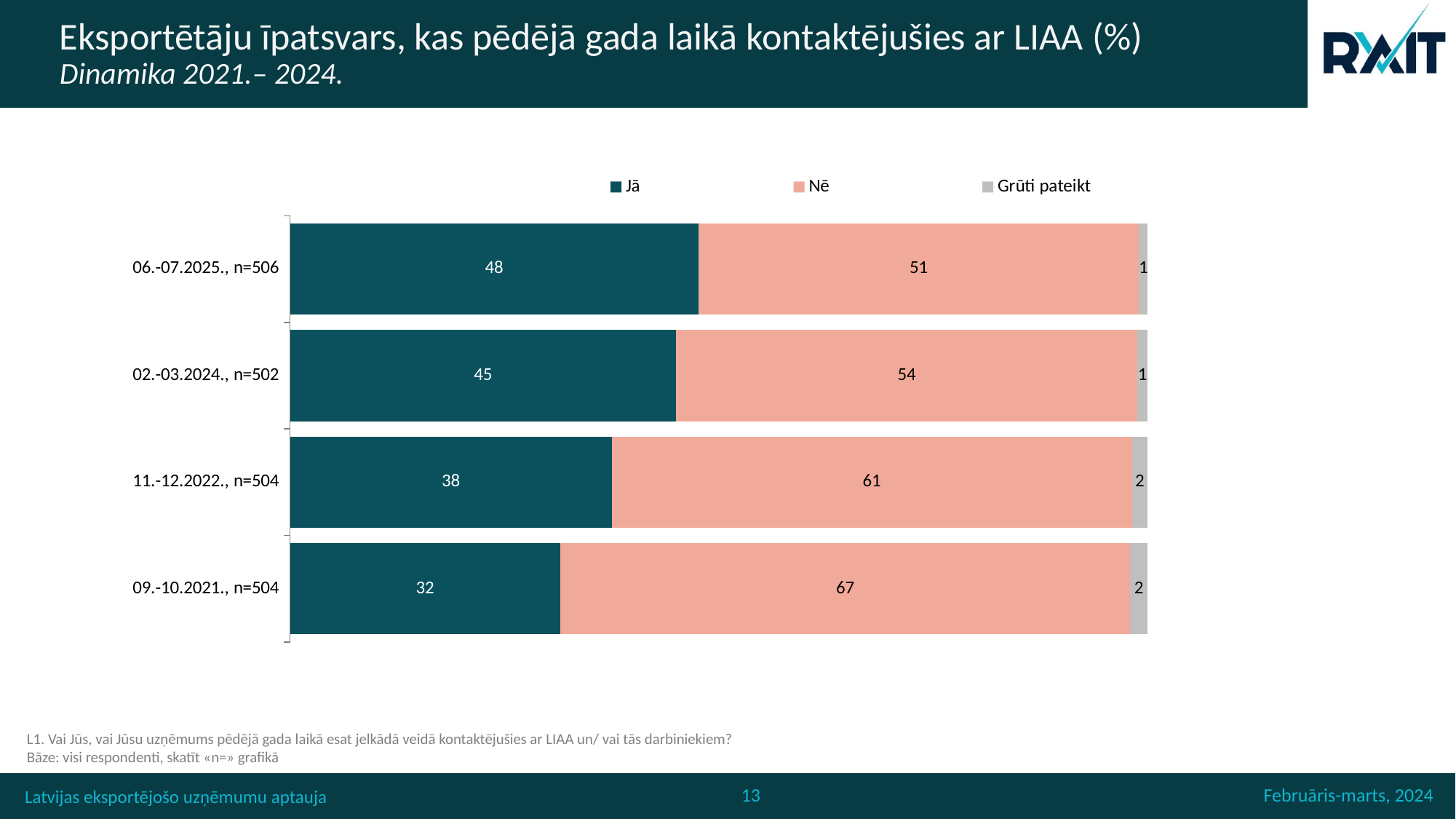
What kind of chart is shown on the slide? Stacked bar chart Which period has the lowest "Nē" value? 06.-07.2025., n=506 What is the value of "Grūti pateikt" for 11.-12.2022., n=504? 2 What is the value of "Jā" for 06.-07.2025., n=506? 48 How many series does the legend list? 3 How many periods are shown in the chart? 4 What is the difference between the "Jā" values for 06.-07.2025., n=506 and 09.-10.2021., n=504? 16 What is the total of the stacked bar for 02.-03.2024., n=502? 100 What is the value of "Nē" for 09.-10.2021., n=504? 67 Which period has the highest "Jā" value? 06.-07.2025., n=506 Which is larger: the "Nē" value for 02.-03.2024., n=502 or for 11.-12.2022., n=504? 11.-12.2022., n=504 Does the "Jā" value rise or fall from 09.-10.2021. to 06.-07.2025.? Rise